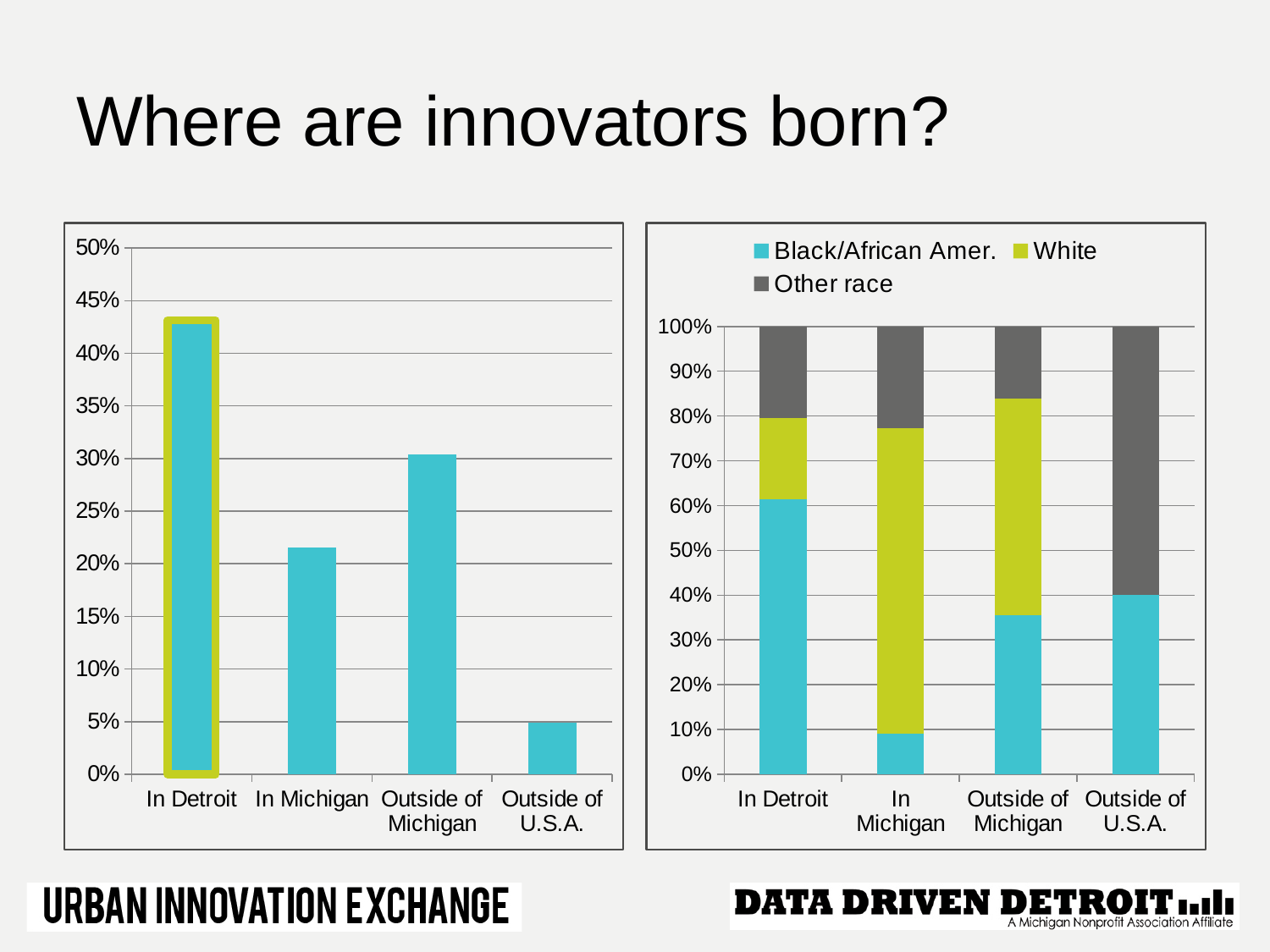
In the chart on the right, is the Black/African Amer. share for In Michigan greater or less than 20%? less How many series does the legend of the chart on the right list? 3 In the chart on the right, which category has the largest Black/African Amer. share? In Detroit In the chart on the left, which category has the lowest value? Outside of U.S.A. In the chart on the left, is the value for In Michigan greater or less than 25%? less In the chart on the right, is the Black/African Amer. share for In Detroit greater or less than 50%? greater In the chart on the left, which is larger: the value for Outside of Michigan or the value for In Michigan? Outside of Michigan How many categories are shown on the x axis of the chart on the left? 4 What kind of chart is the chart on the left of the slide? bar chart What are the legend entries of the chart on the right? Black/African Amer., White, Other race In the chart on the left, which category has the highest value? In Detroit